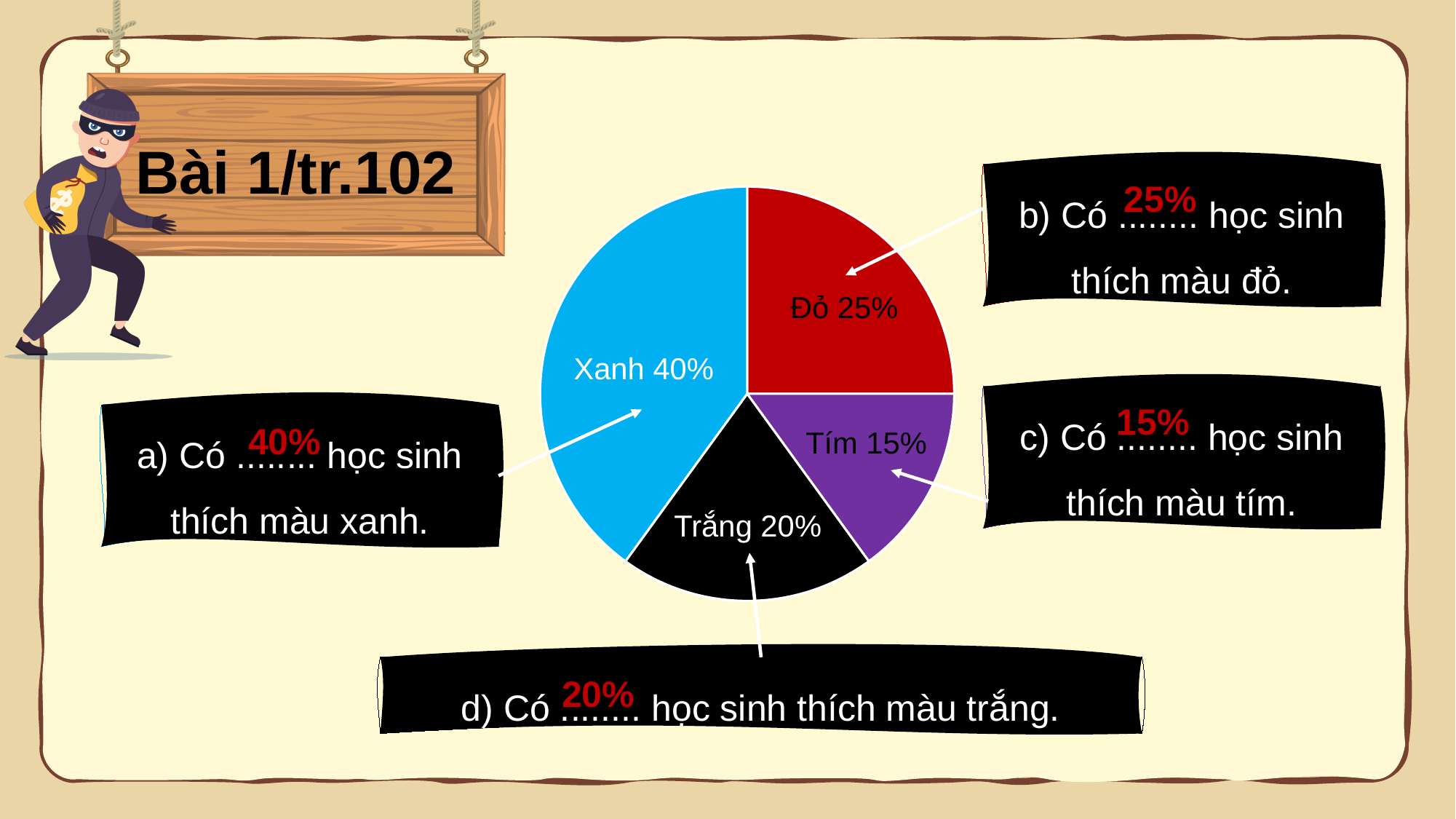
What colour is the Trắng slice drawn in on the pie chart? black What percentage of the pie chart is labelled Trắng? 20% What percentage of the pie chart is labelled Tím? 15% What percentage of the pie chart is labelled Xanh? 40% Which slice of the pie chart is the largest? Xanh Which slice is larger, Đỏ or Trắng? Đỏ Which slice of the pie chart is the smallest? Tím How many slices does the pie chart have? 4 What kind of chart is shown on the slide? pie chart What is the combined share of the Đỏ and Tím slices? 40% What percentage of the pie chart is labelled Đỏ? 25% What is the difference in percentage points between the Xanh slice and the Tím slice? 25%